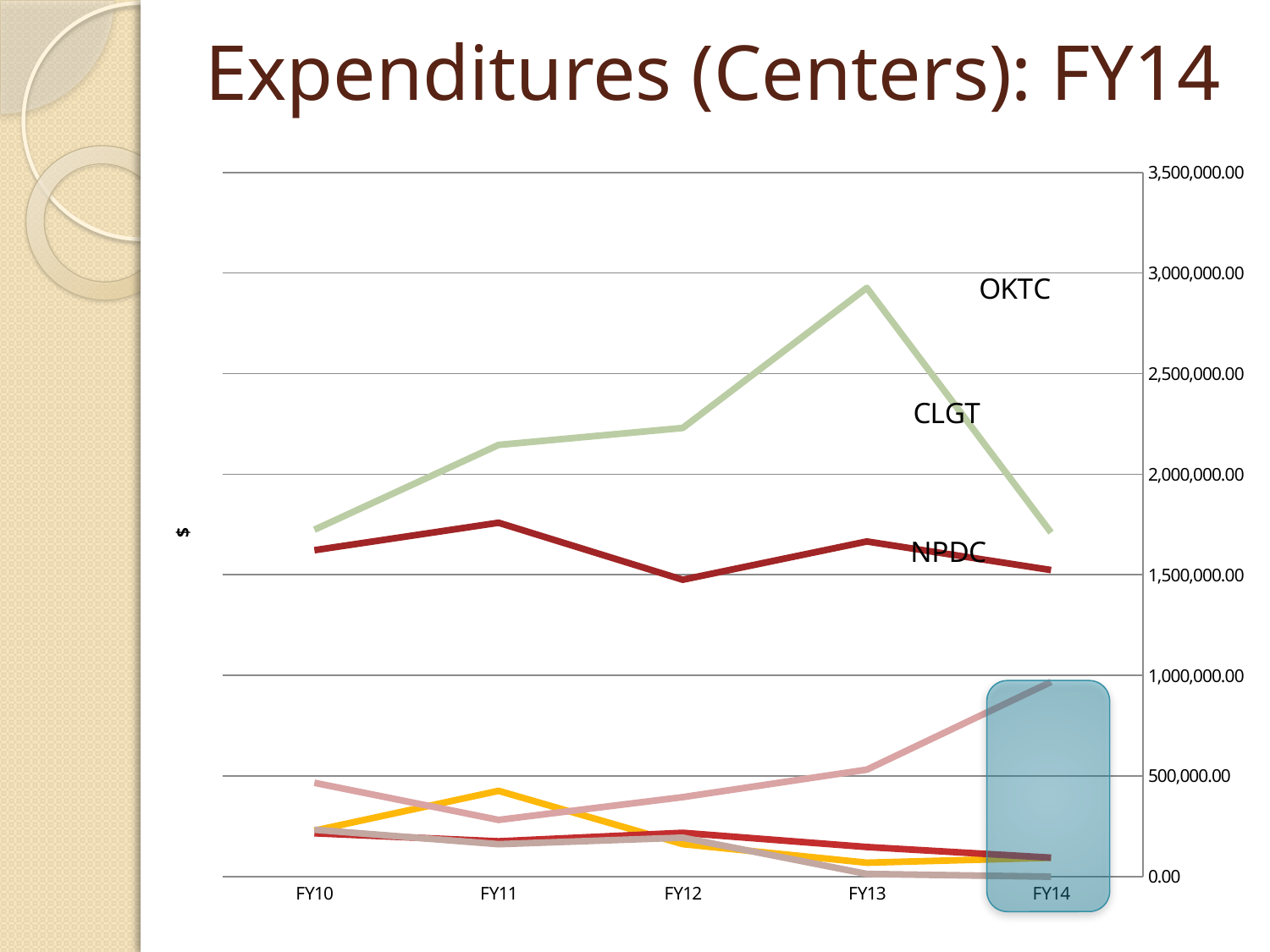
Does the green line rise or fall from FY13 to FY14? fall Is the value of the green line at FY13 greater or less than 2,500,000.00? greater In which fiscal year does the highest (green) line reach its peak? FY13 At FY13, which is higher: the green line or the upper dark red line? The green line What type of chart is shown on the slide? Line chart Is the value of the upper dark red line at FY11 greater or less than 1,500,000.00? greater Is the value of the green line at FY14 greater or less than 2,000,000.00? less How many fiscal years are shown on the x axis? 5 Does the pink line rise or fall from FY11 to FY14? rise What is the highest value shown on the y axis? 3,500,000.00 What is the title of the chart? Expenditures (Centers): FY14